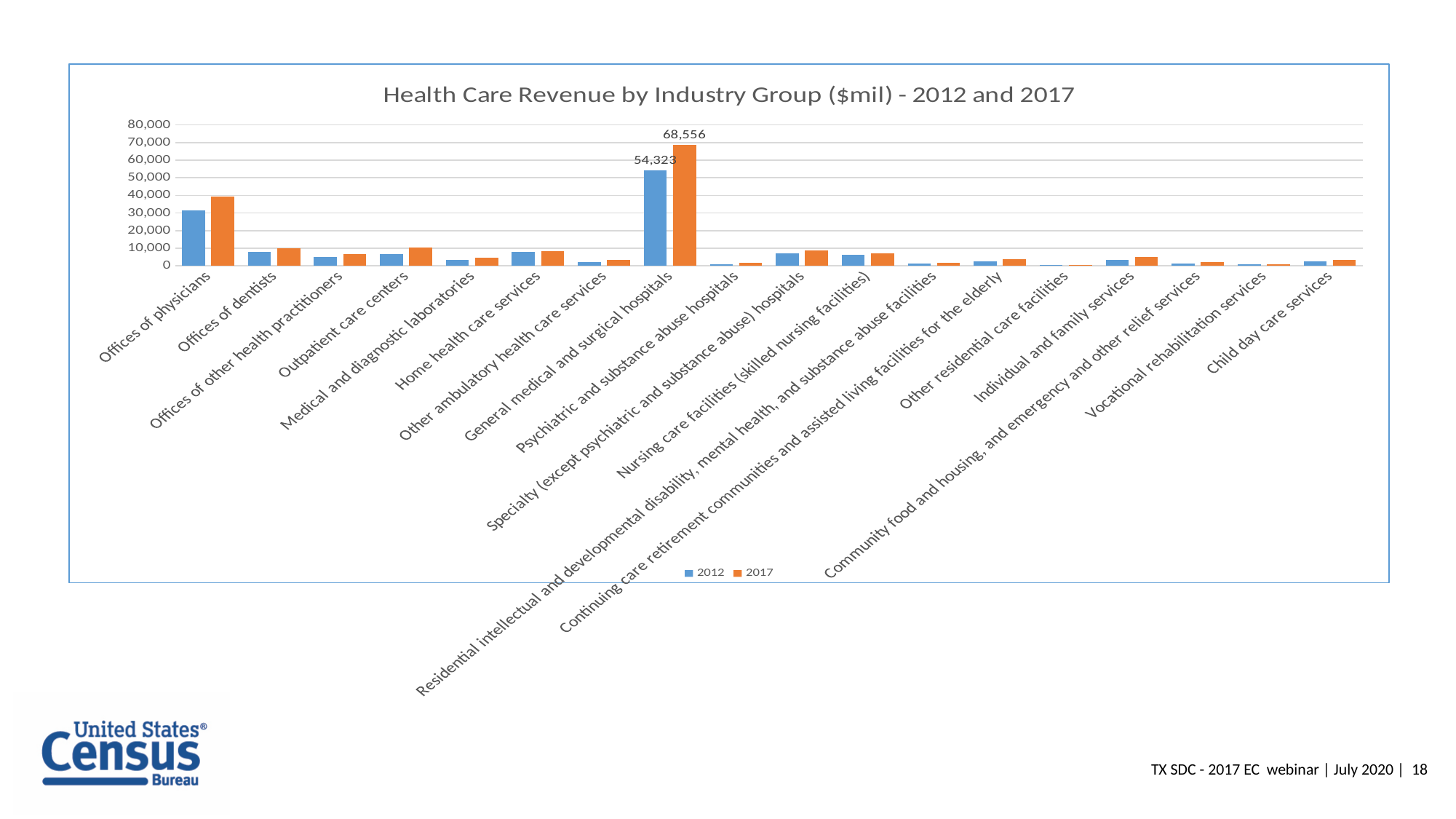
What is the 2012 revenue for General medical and surgical hospitals? 54,323 Is the 2017 value for Offices of physicians greater or less than 30,000? greater What is the difference between the 2017 and 2012 revenue for General medical and surgical hospitals? 14,233 What type of chart is shown on the slide? Bar chart For Offices of physicians, which is larger, the 2012 value or the 2017 value? 2017 What is the title of the chart? Health Care Revenue by Industry Group ($mil) - 2012 and 2017 Is the 2012 value for Offices of dentists greater or less than 20,000? less Which industry group has the highest 2017 revenue? General medical and surgical hospitals Which industry group has the highest 2012 revenue? General medical and surgical hospitals What is the 2017 revenue for General medical and surgical hospitals? 68,556 How many series does the legend list? 2 How many industry groups are shown on the x axis? 18